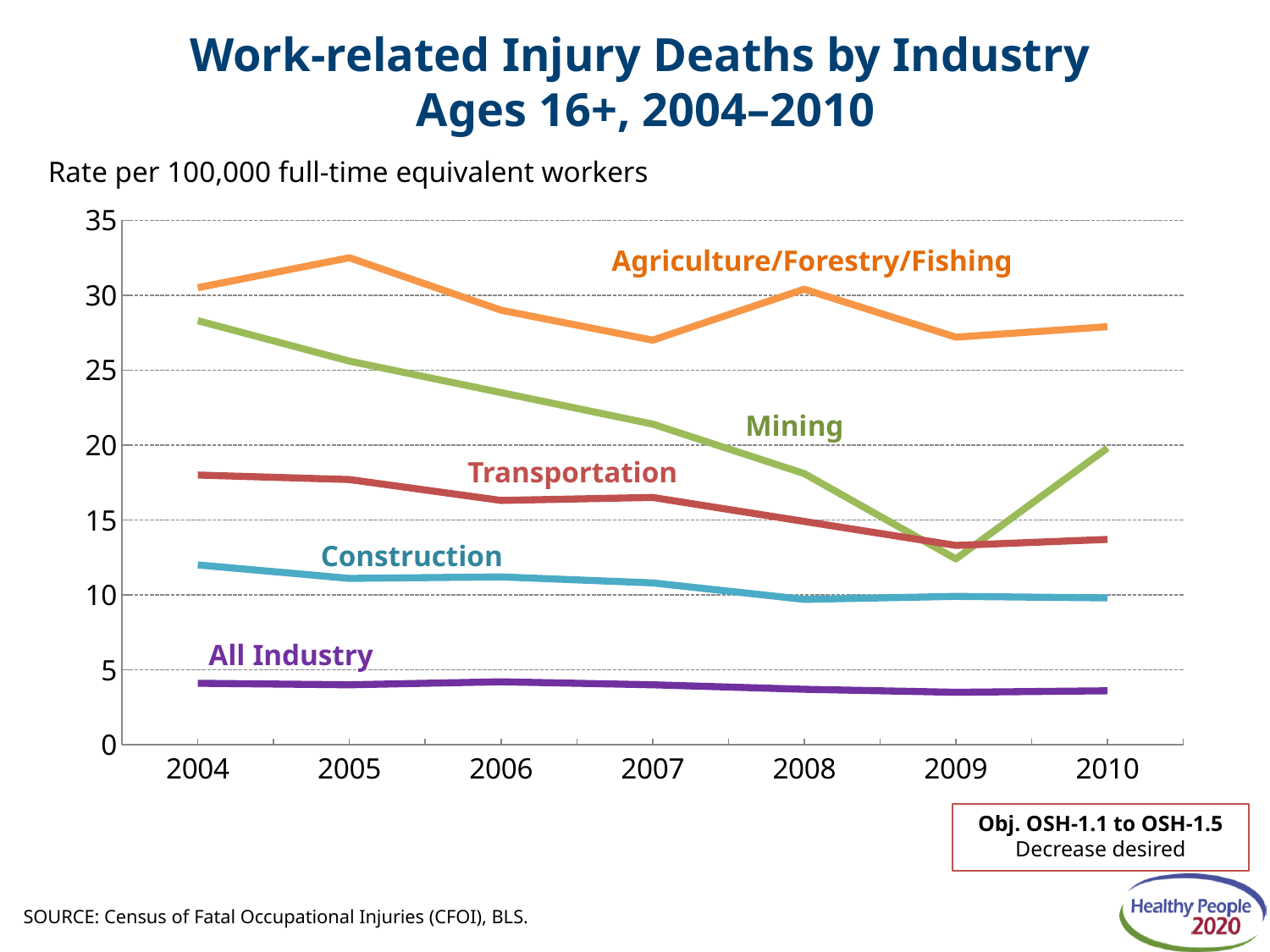
Is the Mining rate in 2004 greater or less than 25? greater How many industry series are plotted on the chart? 5 Which series has the lowest rate across all years shown? All Industry What kind of chart is shown on the slide? line chart Which is larger in 2010, the Mining rate or the Transportation rate? Mining How many years are plotted along the x axis? 7 Which industry has the highest work-related injury death rate in 2004? Agriculture/Forestry/Fishing Does the Mining rate rise or fall from 2004 to 2009? fall Is the Agriculture/Forestry/Fishing rate in 2007 greater or less than 30? less What unit is the rate measured in, according to the subtitle above the chart? Rate per 100,000 full-time equivalent workers Which is larger in 2009, the Mining rate or the Transportation rate? Transportation